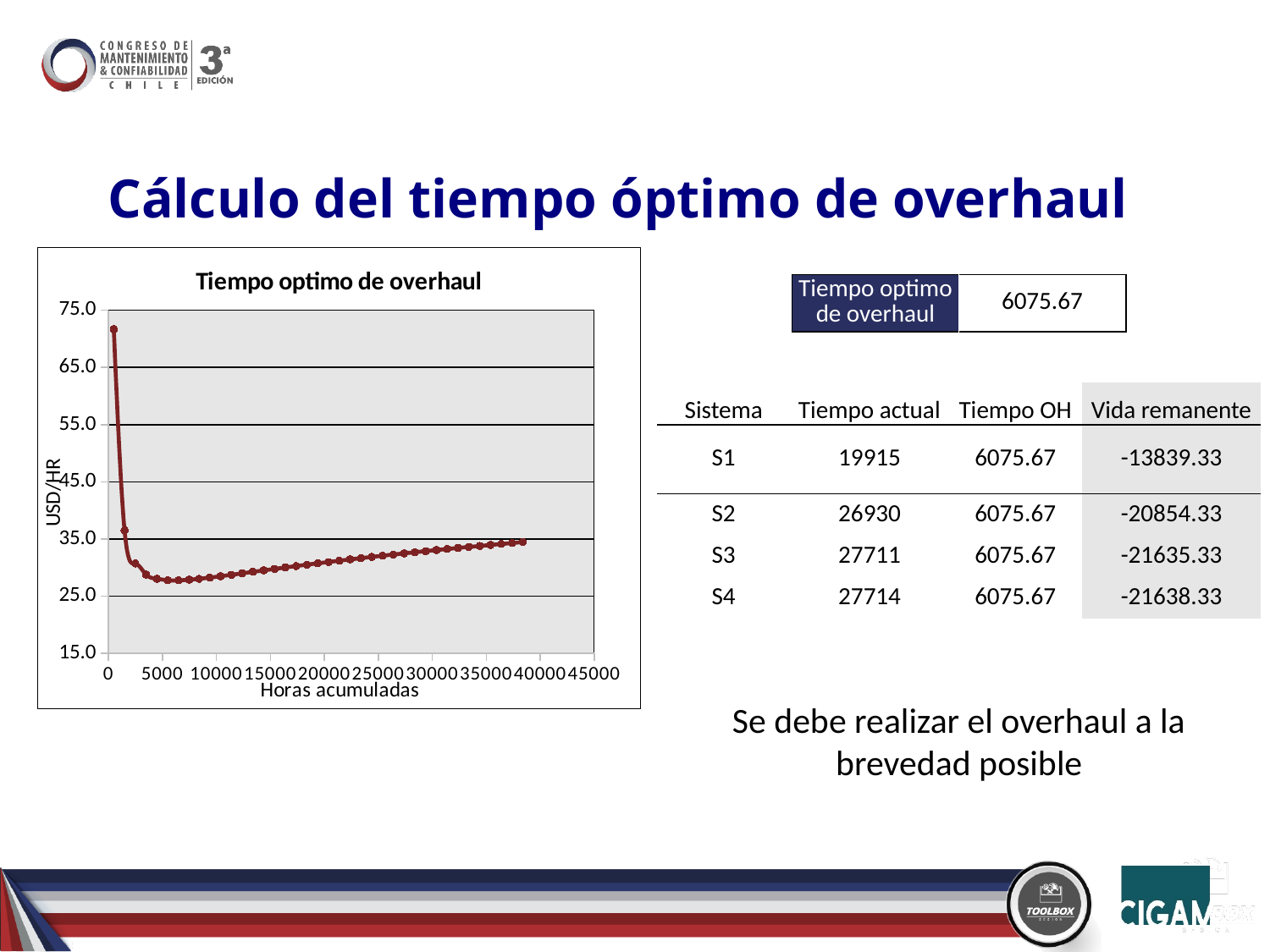
What is the highest value shown on the y axis of the chart? 75.0 What is the title of the chart? Tiempo optimo de overhaul Is the value at 0 hours greater or less than 65? greater Is the value at 20000 hours greater or less than 25? greater Do the values on the chart rise or fall between 10000 and 40000 hours? rise What is the label of the x axis of the chart? Horas acumuladas Is the value at 20000 hours greater or less than 35? less Which is larger, the value at 0 hours or the value at 40000 hours? the value at 0 hours What kind of chart is shown on the slide? line chart Do the values on the chart rise or fall between 0 and 5000 hours? fall How many lines (series) are plotted on the chart? 1